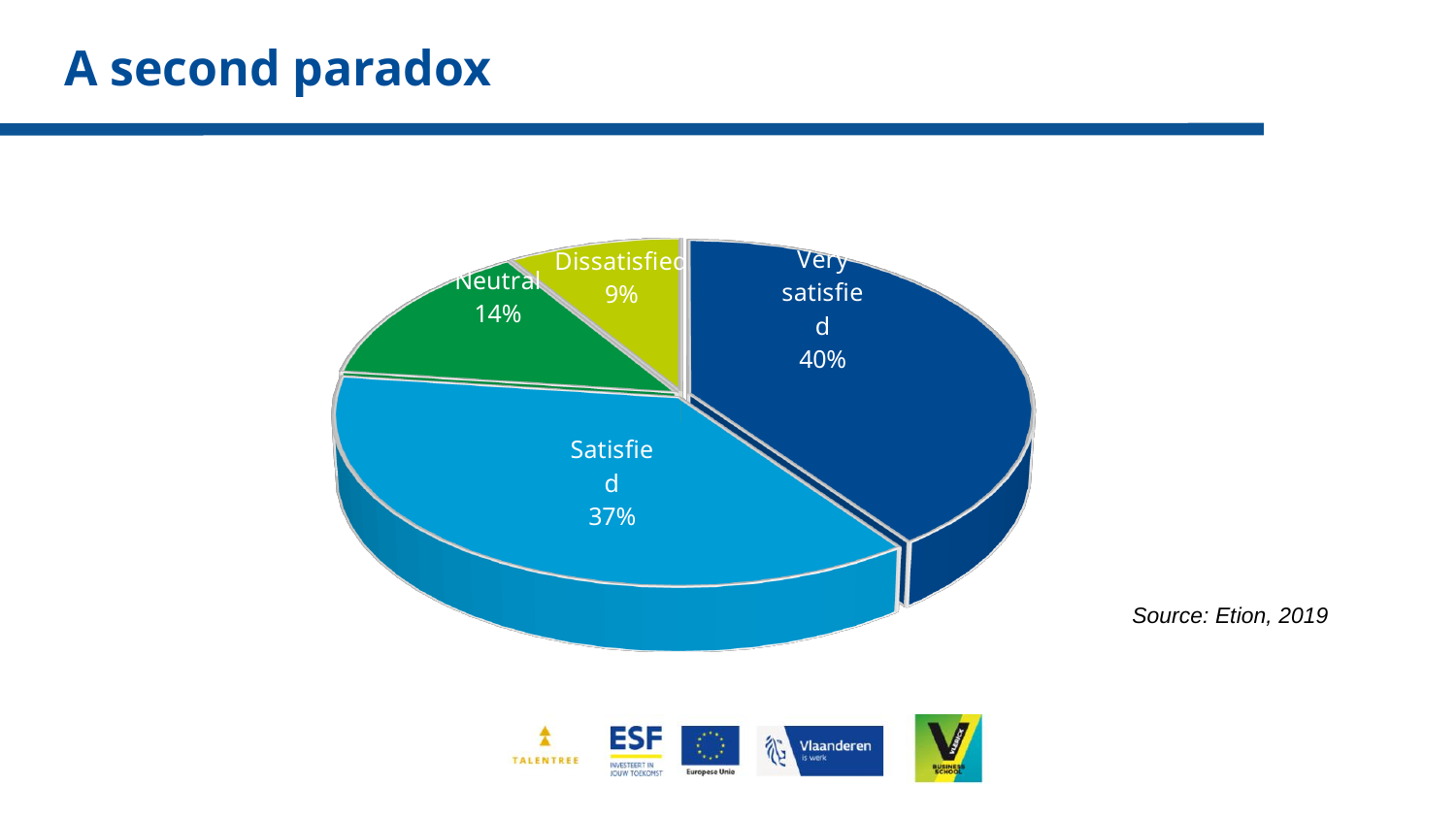
What percentage of the pie chart is labelled "Very satisfied"? 40% What is the difference in percentage points between the "Neutral" and "Dissatisfied" slices? 5 Which slice of the pie chart is the largest? Very satisfied What percentage of the pie chart is labelled "Dissatisfied"? 9% Which is larger, the "Neutral" slice or the "Dissatisfied" slice? Neutral What kind of chart is shown on the slide? Pie chart Which slice of the pie chart is the smallest? Dissatisfied What is the difference in percentage points between the "Very satisfied" and "Satisfied" slices? 3 What source is cited for the chart on the slide? Etion, 2019 What percentage of the pie chart is labelled "Satisfied"? 37% How many slices does the pie chart have? 4 What percentage of the pie chart is labelled "Neutral"? 14%